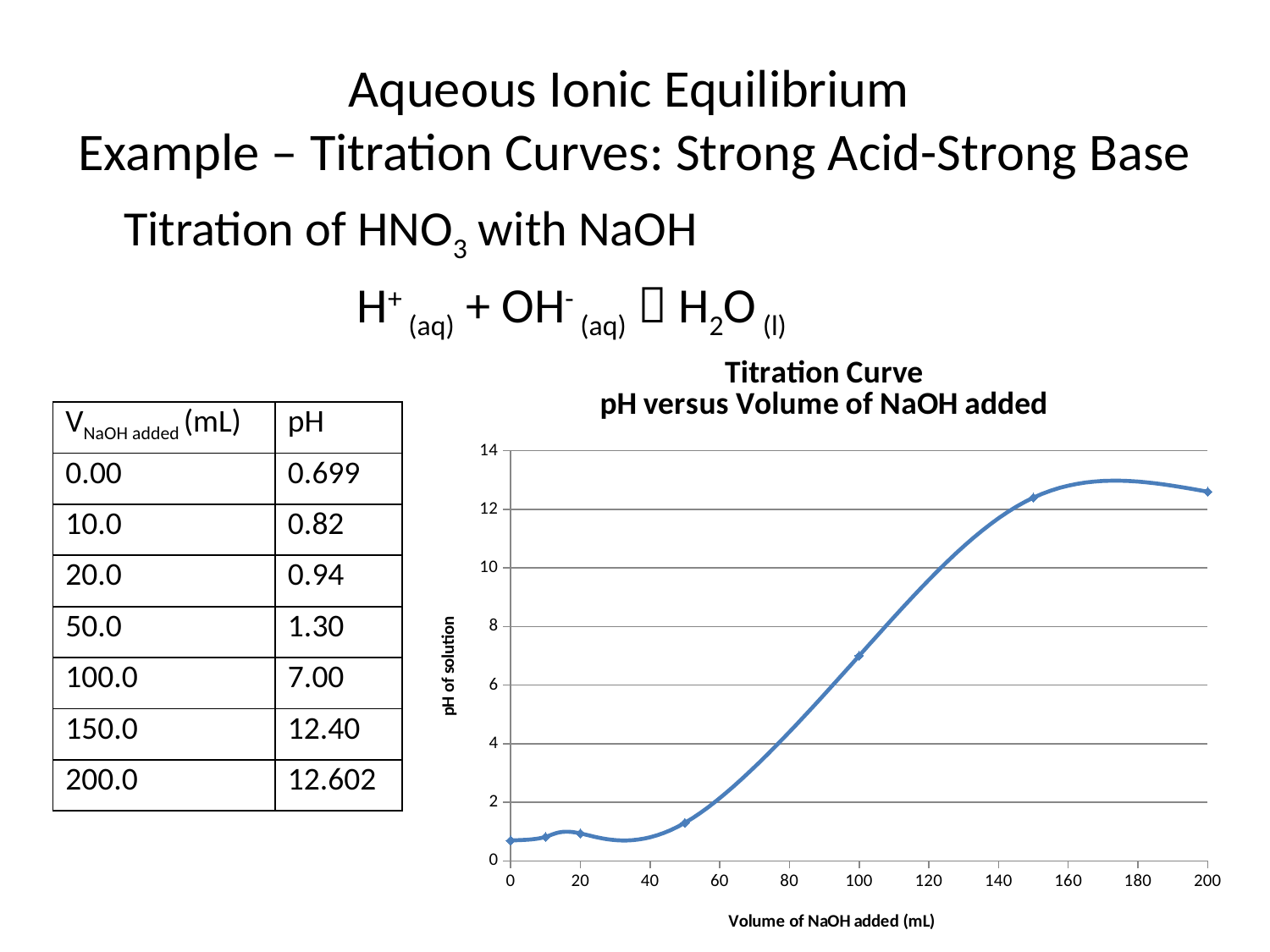
What is the label of the chart's x axis? Volume of NaOH added (mL) How many data points are plotted on the titration curve? 7 What is the title of the chart? Titration Curve pH versus Volume of NaOH added According to the slide, what is the pH when 150.0 mL of NaOH has been added? 12.40 Does the pH generally rise or fall as the volume of NaOH added increases? rise Is the pH at 150 mL of NaOH added greater or less than 12? greater What kind of chart is shown on the slide? line chart What is the difference in pH between 100.0 mL and 50.0 mL of NaOH added? 5.70 According to the slide, what is the pH when 0.00 mL of NaOH has been added? 0.699 Which has the higher pH: 50.0 mL of NaOH added or 100.0 mL of NaOH added? 100.0 mL Is the pH at 50 mL of NaOH added greater or less than 2? less According to the slide, what is the pH when 100.0 mL of NaOH has been added? 7.00